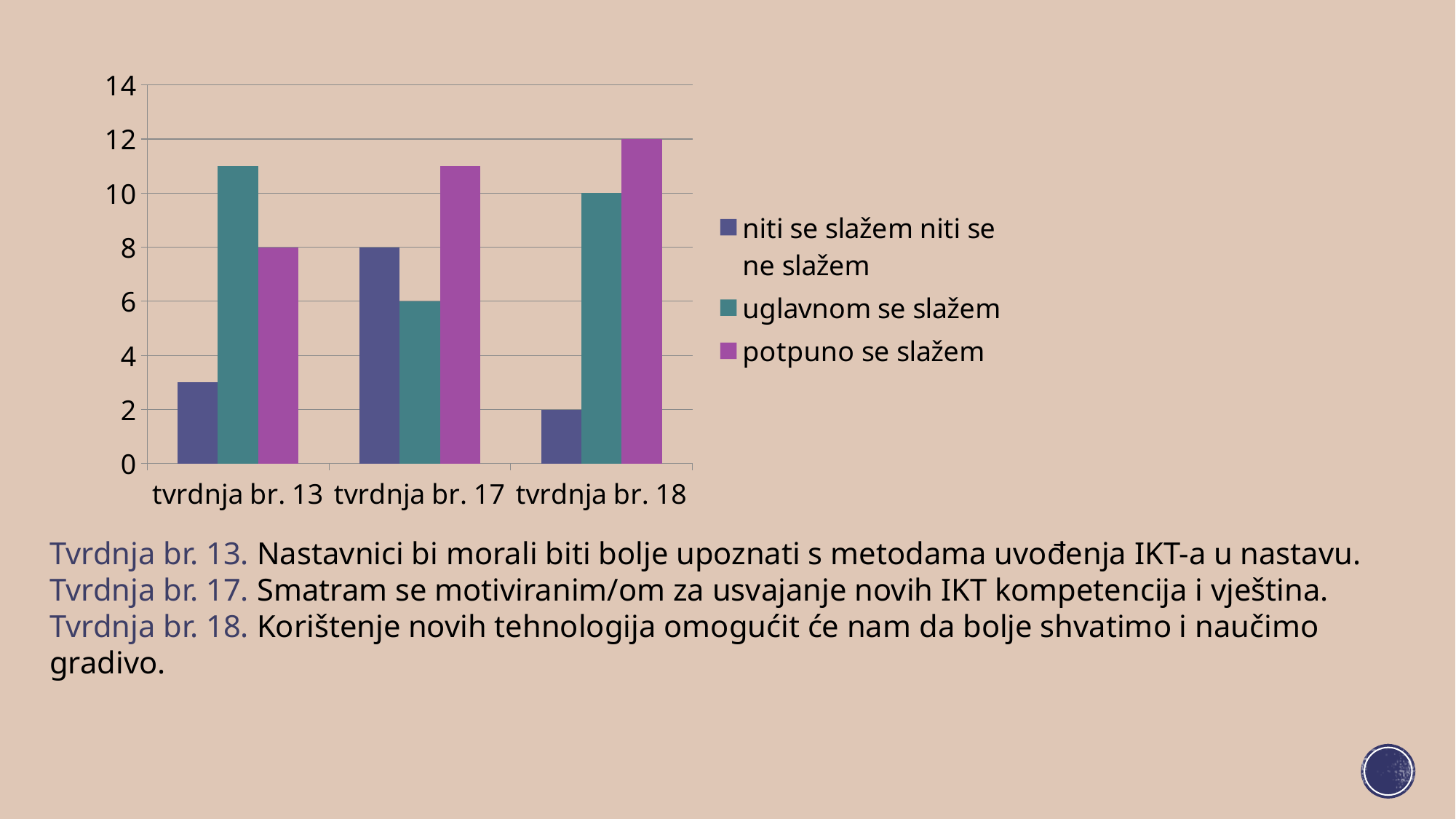
Which category has the highest "potpuno se slažem" value? tvrdnja br. 18 What kind of chart is shown on the slide? bar chart Is the value of "niti se slažem niti se ne slažem" for tvrdnja br. 13 greater or less than 4? less What is the value of "uglavnom se slažem" for tvrdnja br. 17? 6 How many categories (tvrdnje) are shown on the x axis of the chart? 3 How many series does the chart's legend list? 3 What is the value of "potpuno se slažem" for tvrdnja br. 18? 12 Is the value of "uglavnom se slažem" for tvrdnja br. 13 greater or less than 10? greater For tvrdnja br. 18, what is the difference between the "potpuno se slažem" value and the "uglavnom se slažem" value? 2 What is the value of "niti se slažem niti se ne slažem" for tvrdnja br. 18? 2 Which category has the lowest "niti se slažem niti se ne slažem" value? tvrdnja br. 18 For tvrdnja br. 17, which is larger: "niti se slažem niti se ne slažem" or "uglavnom se slažem"? niti se slažem niti se ne slažem